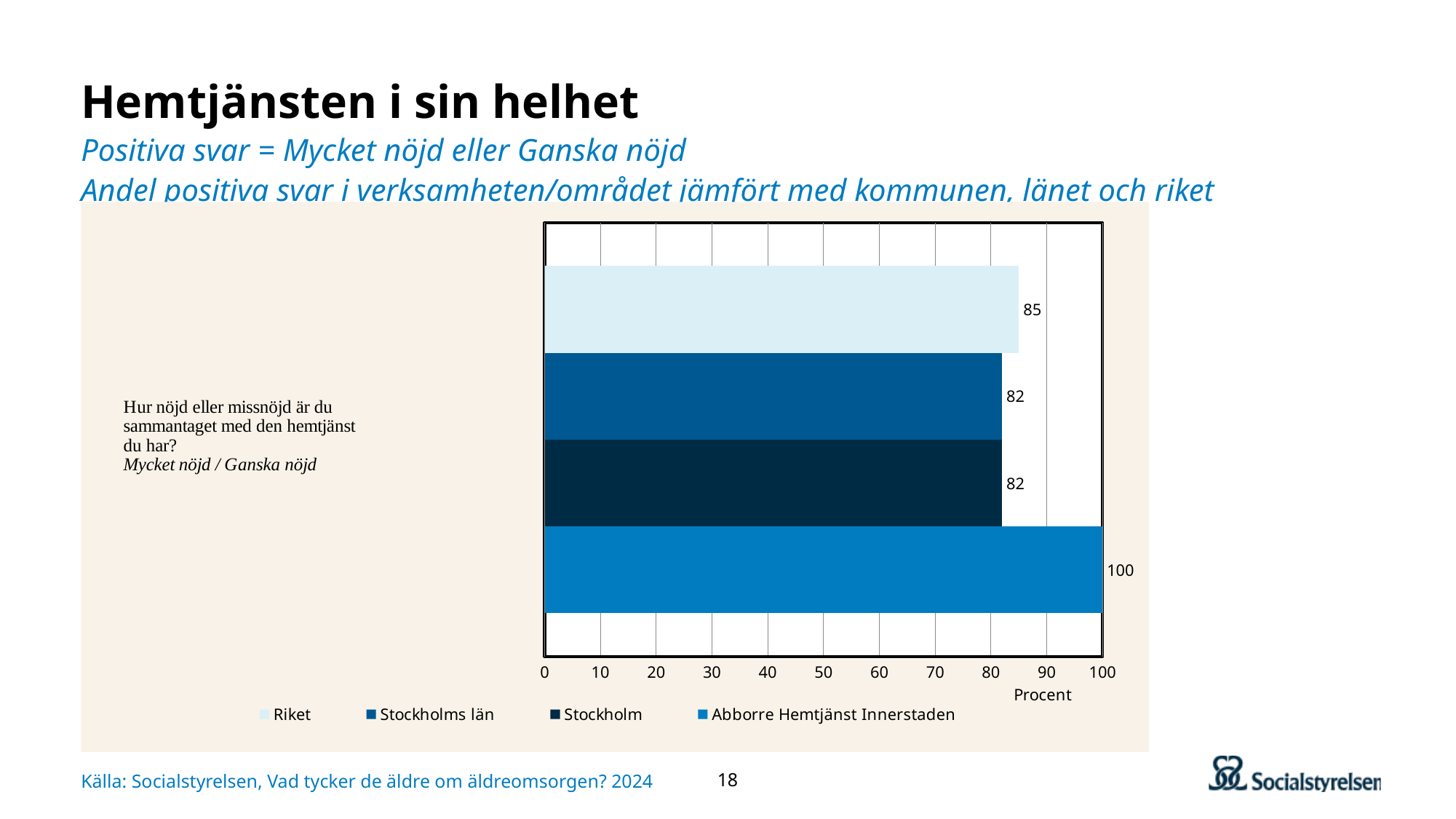
What is the value for Abborre Hemtjänst Innerstaden? 100 What unit is shown on the x axis of the chart? Procent Which series has the highest value? Abborre Hemtjänst Innerstaden What is the value for Stockholms län? 82 What is the difference between the values for Riket and Stockholms län? 3 How many series does the legend list? 4 What kind of chart is shown on the slide? Bar chart Is the value for Stockholms län greater or less than 90? less What is the value for Stockholm? 82 What is the difference between the values for Abborre Hemtjänst Innerstaden and Riket? 15 What is the value for Riket? 85 Which is larger, the value for Riket or the value for Stockholm? Riket